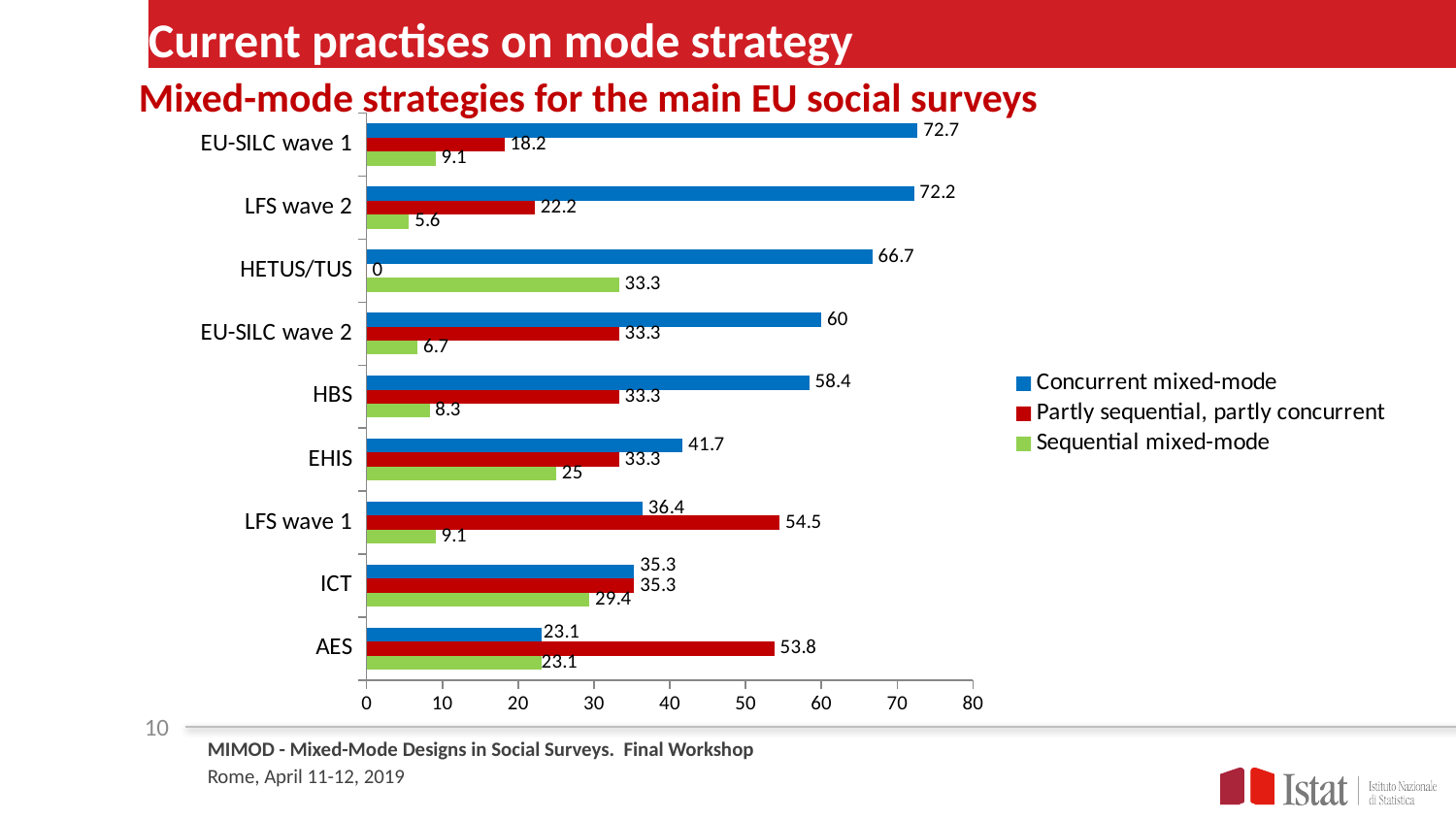
How many series does the legend list? 3 What is the value of Partly sequential, partly concurrent for LFS wave 1? 54.5 What kind of chart is shown on the slide? Bar chart For AES, which is larger: Concurrent mixed-mode or Partly sequential, partly concurrent? Partly sequential, partly concurrent Which survey has the lowest Sequential mixed-mode value? LFS wave 2 Which survey has the highest Sequential mixed-mode value? HETUS/TUS How many surveys are shown on the chart? 9 Is the Concurrent mixed-mode value for HBS greater or less than 50? greater What is the difference between the Concurrent mixed-mode and Partly sequential, partly concurrent values for EU-SILC wave 1? 54.5 What is the value of Sequential mixed-mode for ICT? 29.4 What is the value of Concurrent mixed-mode for EU-SILC wave 1? 72.7 Which survey has the lowest Partly sequential, partly concurrent value? HETUS/TUS